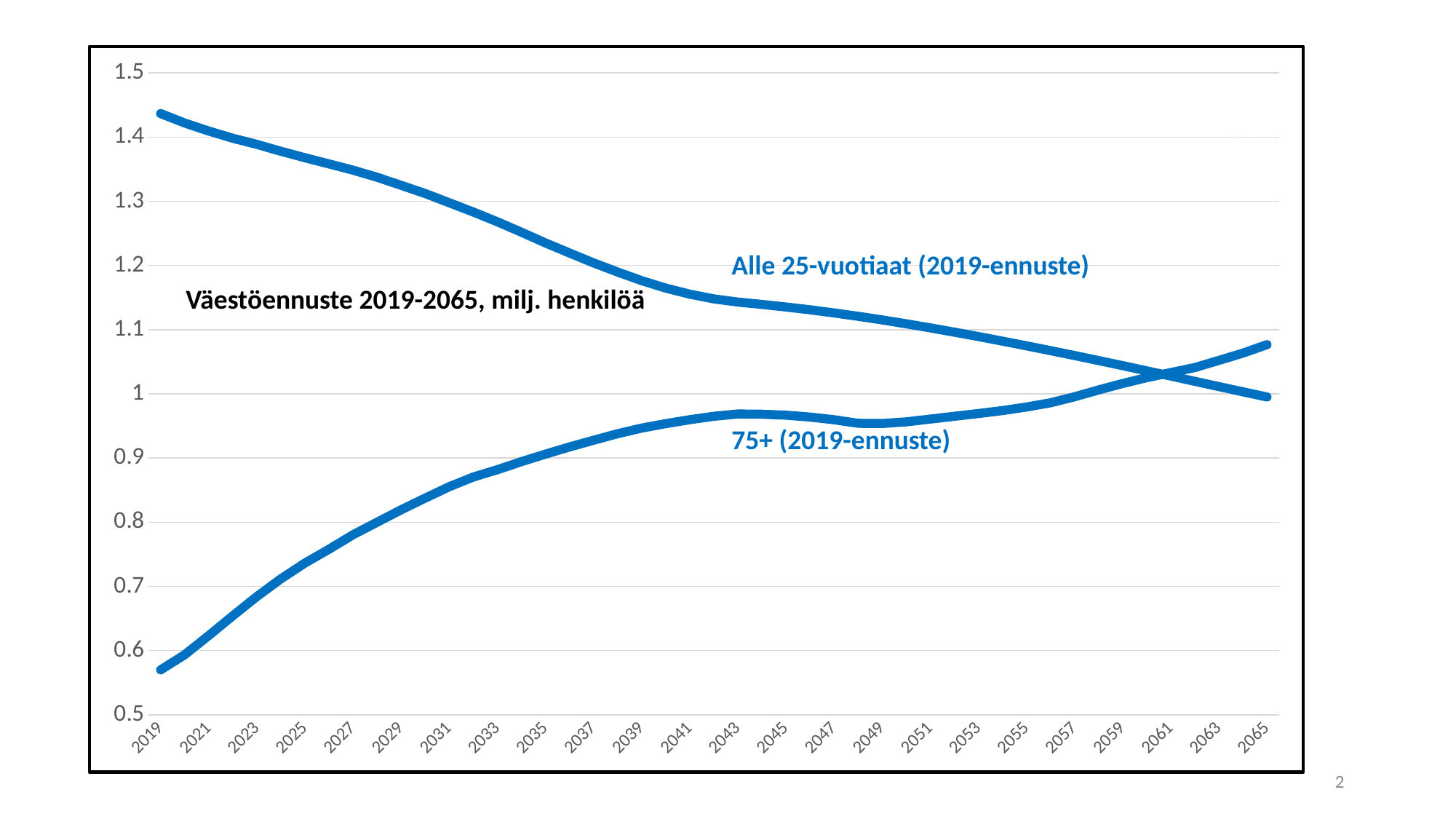
What is the title text shown on the chart? Väestöennuste 2019-2065, milj. henkilöä In 2065, which series has the higher value: 'Alle 25-vuotiaat (2019-ennuste)' or '75+ (2019-ennuste)'? 75+ (2019-ennuste) Does the 'Alle 25-vuotiaat (2019-ennuste)' line rise or fall from 2019 to 2065? fall What are the names of the two series labelled on the chart? Alle 25-vuotiaat (2019-ennuste) and 75+ (2019-ennuste) In 2019, which series has the higher value: 'Alle 25-vuotiaat (2019-ennuste)' or '75+ (2019-ennuste)'? Alle 25-vuotiaat (2019-ennuste) How many series are plotted on the chart? 2 Is the value for '75+ (2019-ennuste)' in 2019 greater or less than 0.6? less Is the value for 'Alle 25-vuotiaat (2019-ennuste)' in 2019 greater or less than 1.3? greater Does the '75+ (2019-ennuste)' line rise or fall from 2019 to 2065? rise Is the value for 'Alle 25-vuotiaat (2019-ennuste)' in 2065 greater or less than 1.1? less What kind of chart is shown on the slide? line chart